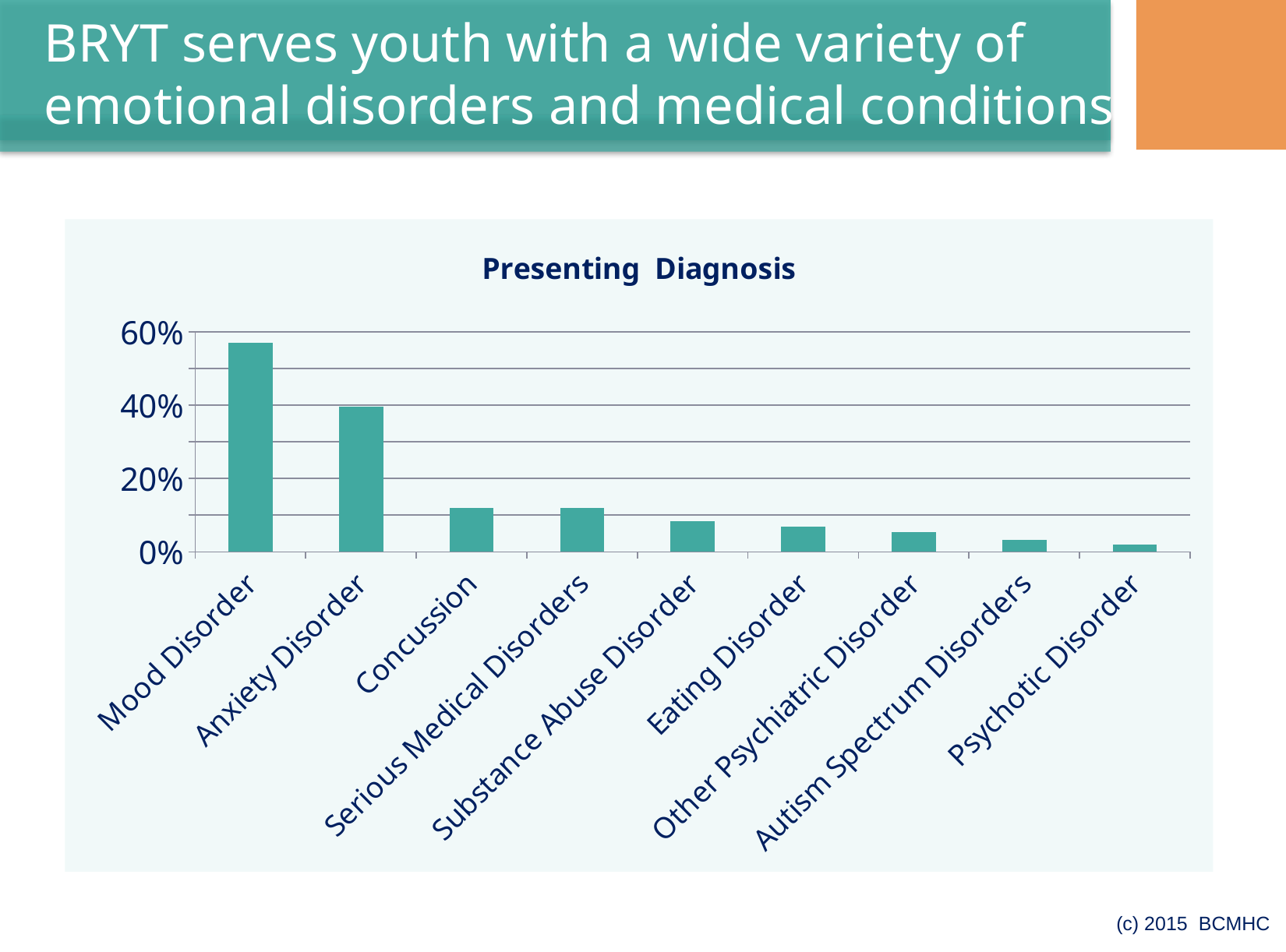
Is the value for Mood Disorder greater or less than 60%? less Which presenting diagnosis has the lowest percentage? Psychotic Disorder Which is larger, the value for Mood Disorder or the value for Anxiety Disorder? Mood Disorder How many diagnosis categories are plotted in the chart? 9 Is the value for Concussion greater or less than 20%? less What colour are the bars in the chart? Teal Which is larger, the value for Concussion or the value for Eating Disorder? Concussion What is the title of the chart? Presenting Diagnosis Do the values generally rise or fall moving from left to right along the x axis? Fall Which presenting diagnosis has the highest percentage? Mood Disorder What kind of chart is shown on the slide? Bar chart Is the value for Mood Disorder greater or less than 40%? greater